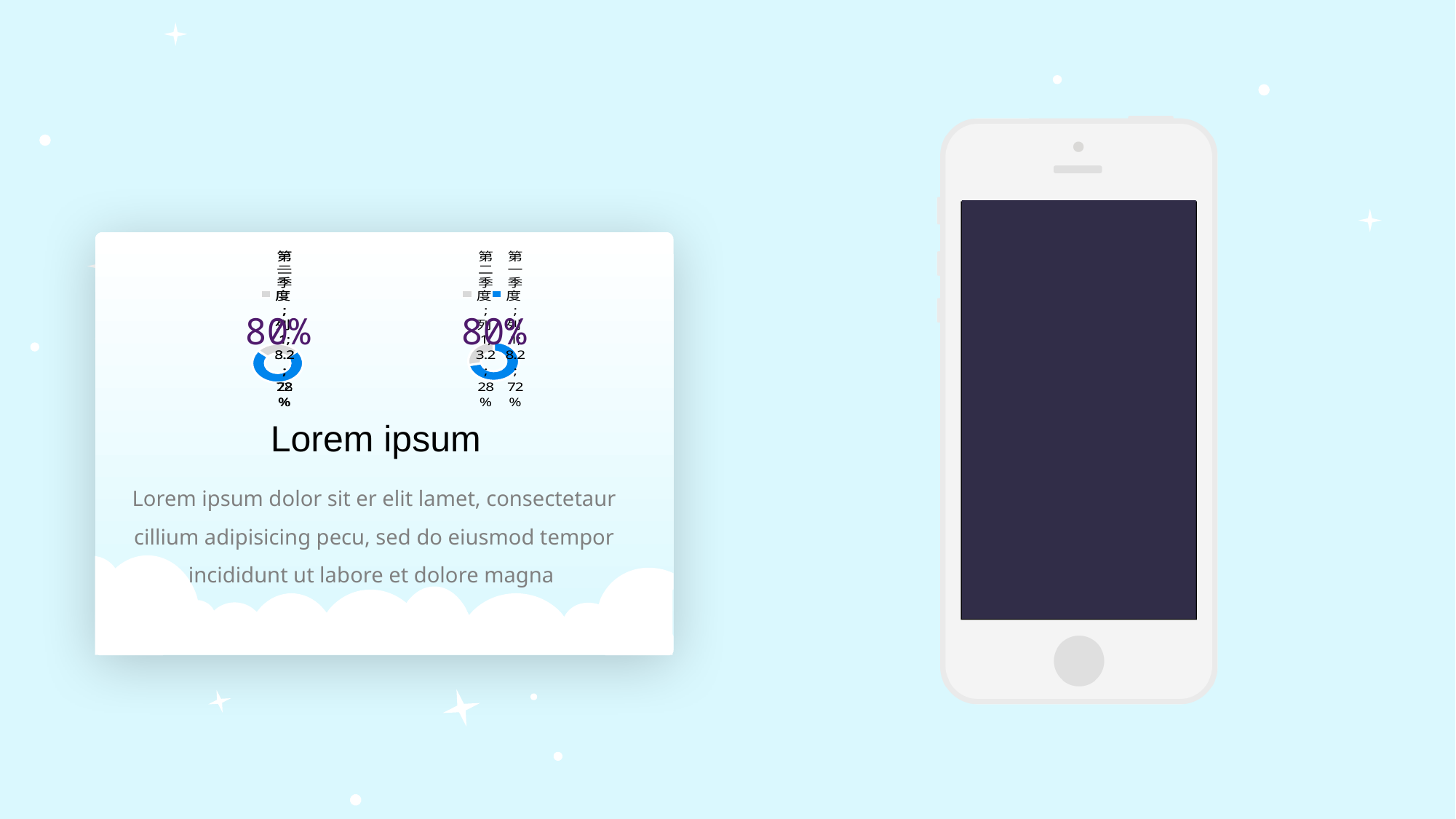
In the right-hand doughnut chart, which slice is larger, 第一季度 or 第二季度? 第一季度 In the right-hand doughnut chart, what value is labelled for 第二季度? 3.2 In the right-hand doughnut chart, what is the difference between the values for 第一季度 and 第二季度? 5.0 How many legend entries does the right-hand doughnut chart show? 2 In the right-hand doughnut chart, what colour is the 第一季度 slice? blue What large percentage text is overlaid on each doughnut chart? 80% In the right-hand doughnut chart, what share is labelled for 第一季度? 72% In the right-hand doughnut chart, what share is labelled for 第二季度? 28% What kind of chart is shown on the left side of the white card? doughnut chart In the right-hand doughnut chart, what value is labelled for 第一季度? 8.2 How many doughnut charts are on the slide? 2